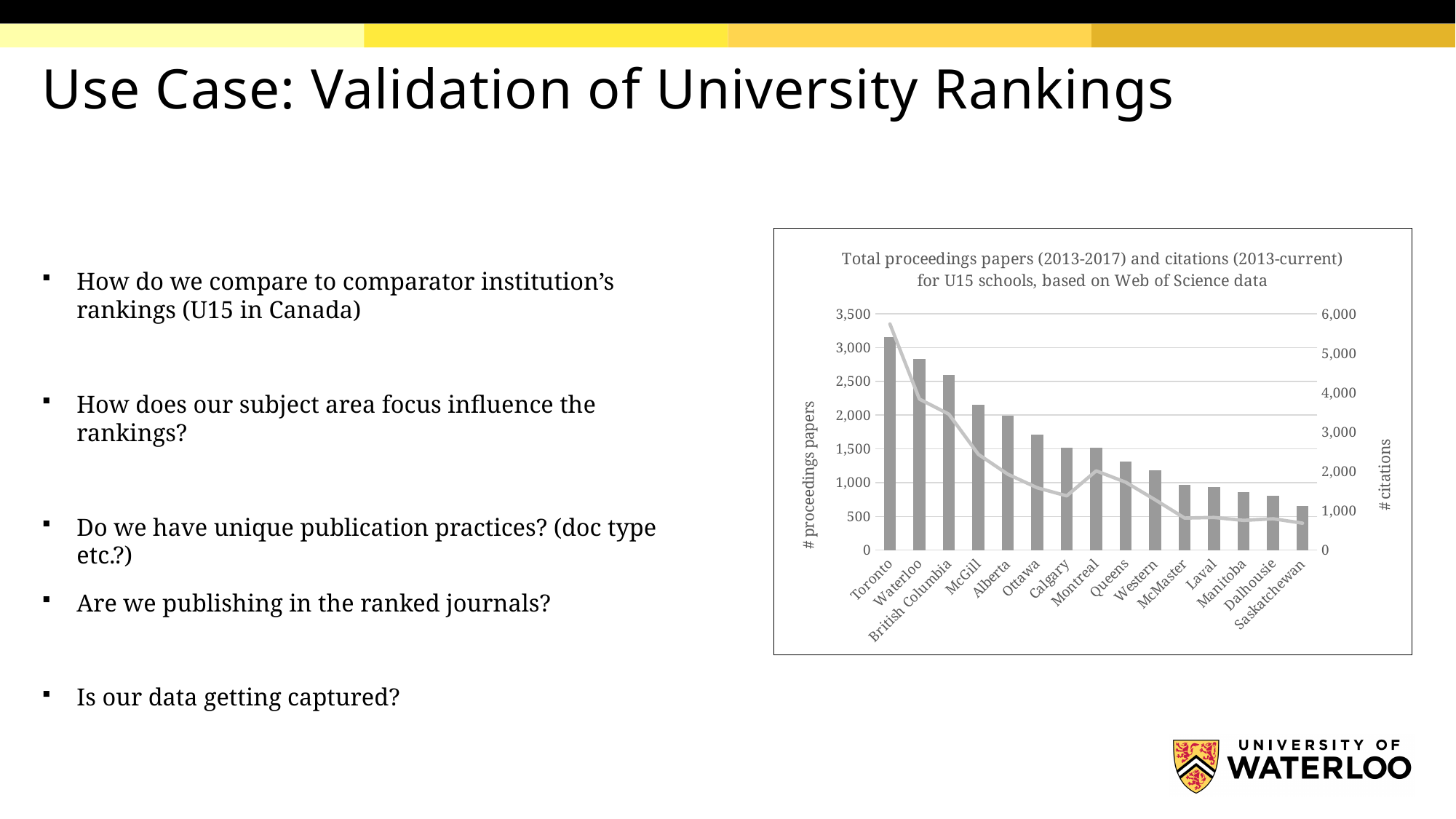
Is the number of proceedings papers for Queens greater or less than 1,000? greater What kind of chart is shown on the slide? bar chart with a line overlay How many schools are shown on the x axis of the chart? 15 What is the label of the right-hand vertical axis of the chart? # citations Is the number of proceedings papers for Waterloo greater or less than 2,500? greater Which school has the lowest number of proceedings papers in the chart? Saskatchewan Which school has the highest number of proceedings papers in the chart? Toronto Is the number of proceedings papers for Saskatchewan greater or less than 500? greater Do the bar values generally rise or fall from left to right along the x axis? fall Which has more proceedings papers, Waterloo or British Columbia? Waterloo